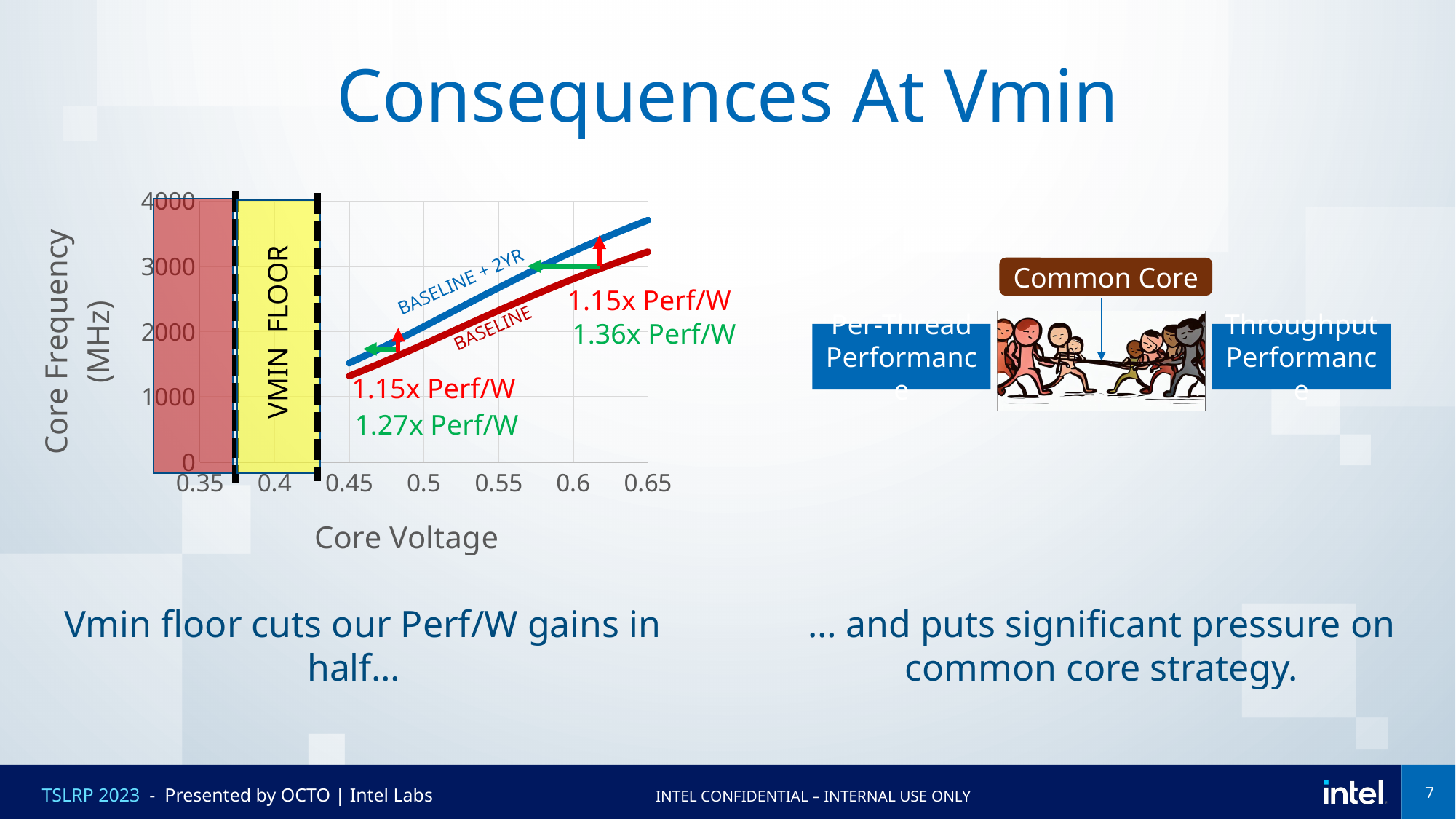
Which line is higher at a Core Voltage of 0.6, BASELINE or BASELINE + 2YR? BASELINE + 2YR Is the BASELINE value at a Core Voltage of 0.45 greater or less than 2000 MHz? less Do the values of the BASELINE line rise or fall as Core Voltage increases? rise How many tick labels are shown on the x axis of the chart? 7 What is the title of the x axis of the chart? Core Voltage Is the BASELINE + 2YR value at a Core Voltage of 0.45 greater or less than 2000 MHz? less Is the BASELINE value at a Core Voltage of 0.65 greater or less than 3000 MHz? greater What is the label of the blue line on the chart? BASELINE + 2YR How many lines (series) are plotted on the chart? 2 What is the green Perf/W gain annotated near the upper (higher voltage) arrows on the chart? 1.36x Perf/W What kind of chart is shown on the slide? line chart What is the green Perf/W gain annotated near the lower (lower voltage) arrows on the chart? 1.27x Perf/W